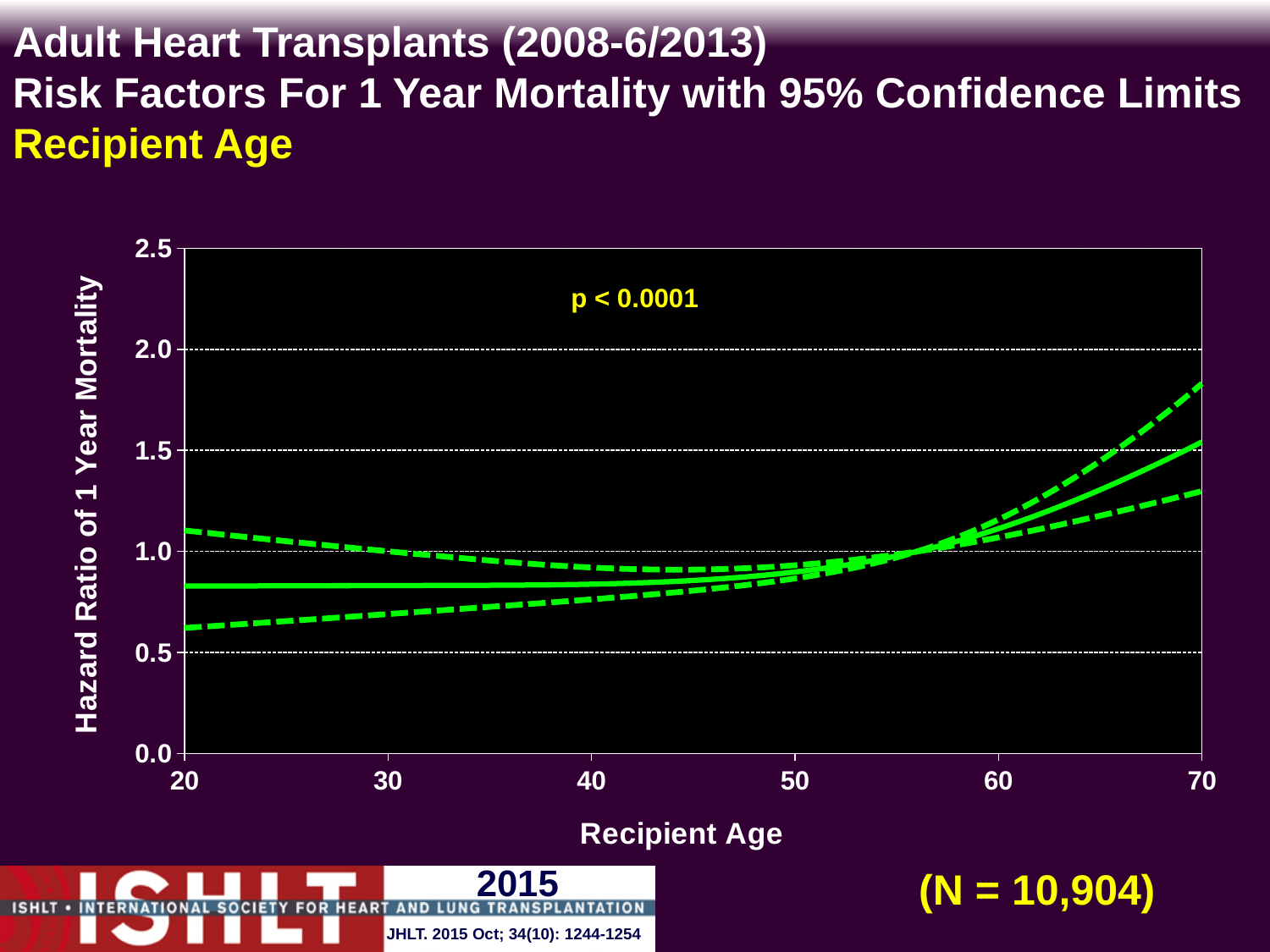
Is the hazard ratio (solid line) at recipient age 20 greater or less than 1.0? less What is the label of the y axis? Hazard Ratio of 1 Year Mortality What p-value is printed on the chart? p < 0.0001 Is the lower confidence limit (lower dashed line) at recipient age 20 greater or less than 0.5? greater Is the upper confidence limit (upper dashed line) at recipient age 70 greater or less than 1.5? greater How many lines are plotted on the chart? 3 What kind of chart is shown on the slide? line chart Which is larger, the hazard ratio (solid line) at recipient age 70 or at recipient age 20? age 70 Does the hazard ratio of 1 year mortality (solid line) rise or fall as recipient age increases from 20 to 70? rise